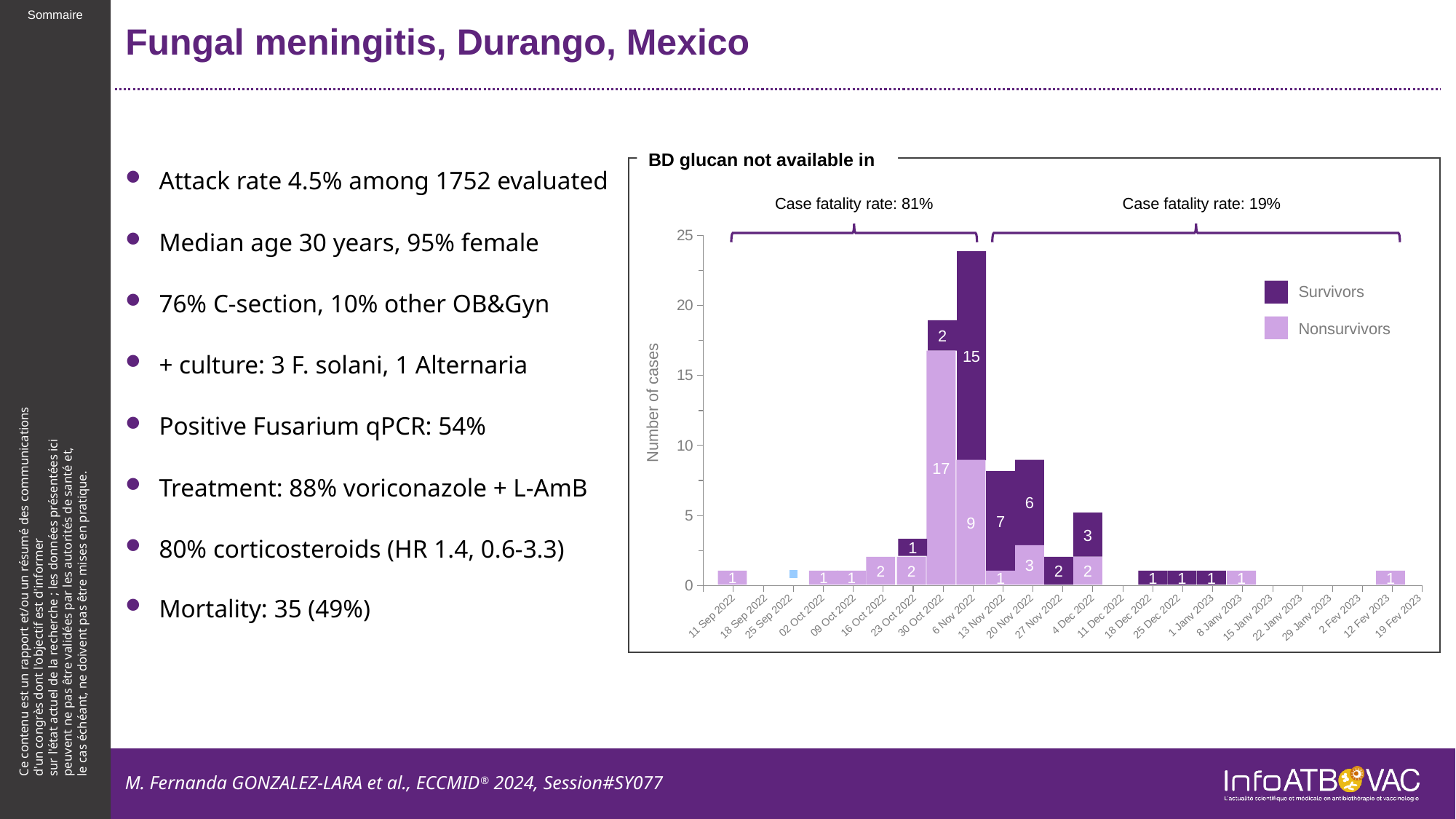
For the week of 4 Dec 2022, which is larger: the number of survivors or the number of nonsurvivors? Survivors How many nonsurvivors are shown for the week of 30 Oct 2022? 17 How many survivors are shown for the week of 6 Nov 2022? 15 What is the difference between the number of nonsurvivors and survivors for the week of 30 Oct 2022? 15 What kind of chart is shown on the slide? Stacked bar chart What are the two series named in the chart legend? Survivors and Nonsurvivors What case fatality rate is shown for the later period of the chart (right bracket)? 19% How many series does the chart legend list? 2 What is the total number of cases in the stacked bar for 6 Nov 2022? 24 How many survivors are shown for the week of 13 Nov 2022? 7 What is the total number of cases in the stacked bar for 20 Nov 2022? 9 Which week has the highest total number of cases? 6 Nov 2022